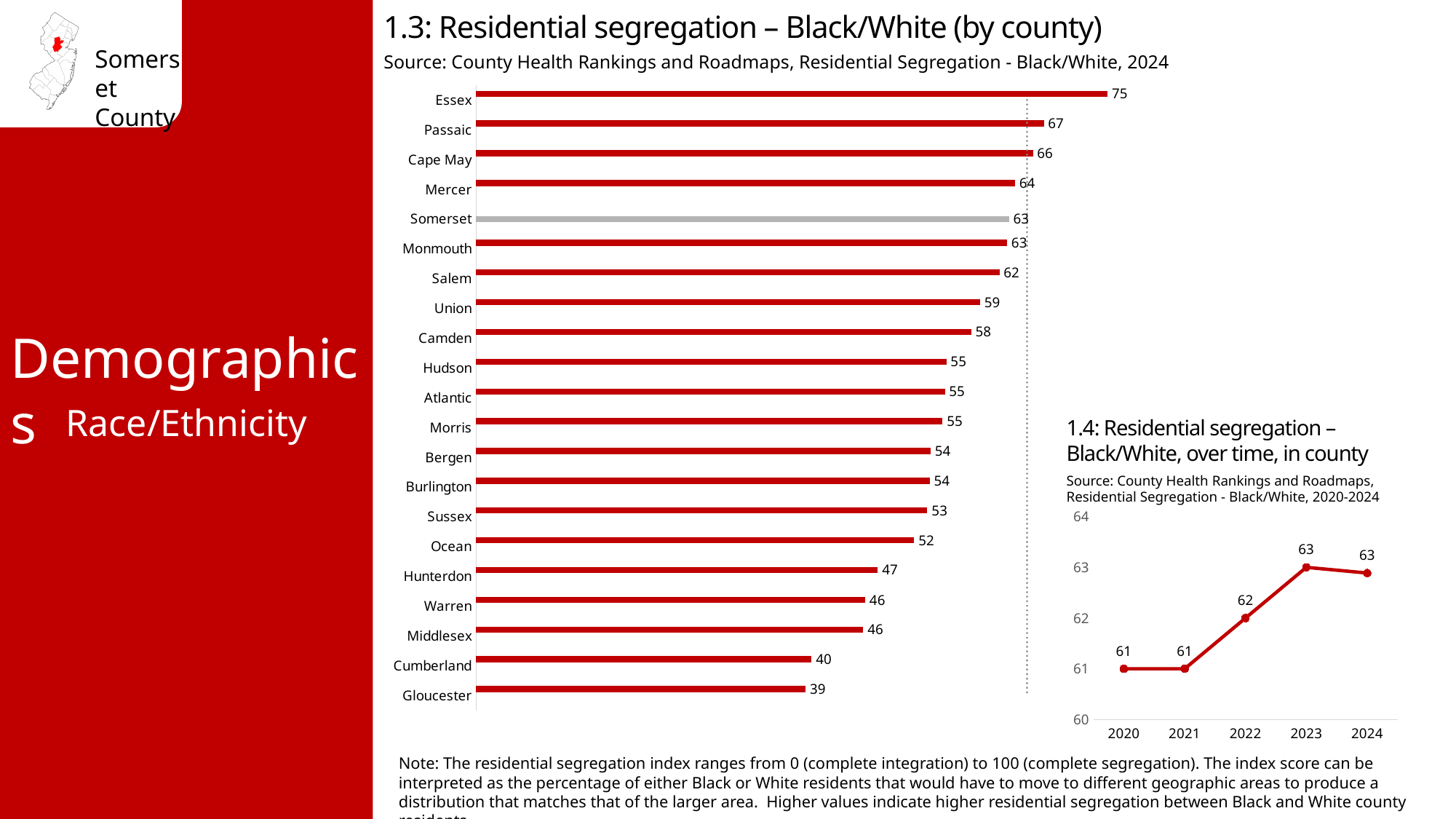
In the chart '1.3: Residential segregation – Black/White (by county)', which has a larger value, Passaic or Cumberland? Passaic In the chart '1.3: Residential segregation – Black/White (by county)', what is the value for Essex? 75 In the chart '1.3: Residential segregation – Black/White (by county)', which county has the highest value? Essex In the chart '1.3: Residential segregation – Black/White (by county)', which county has the lowest value? Gloucester In the chart '1.4: Residential segregation – Black/White, over time, in county', what is the difference between the values for 2020 and 2023? 2 What kind of chart is '1.4: Residential segregation – Black/White, over time, in county'? Line chart What kind of chart is '1.3: Residential segregation – Black/White (by county)'? Bar chart In the chart '1.4: Residential segregation – Black/White, over time, in county', what is the value for 2022? 62 In the chart '1.4: Residential segregation – Black/White, over time, in county', do the values generally rise or fall from 2020 to 2024? Rise In the chart '1.3: Residential segregation – Black/White (by county)', what is the value for Somerset? 63 How many counties are shown in the chart '1.3: Residential segregation – Black/White (by county)'? 21 In the chart '1.3: Residential segregation – Black/White (by county)', what is the difference between the values for Essex and Gloucester? 36